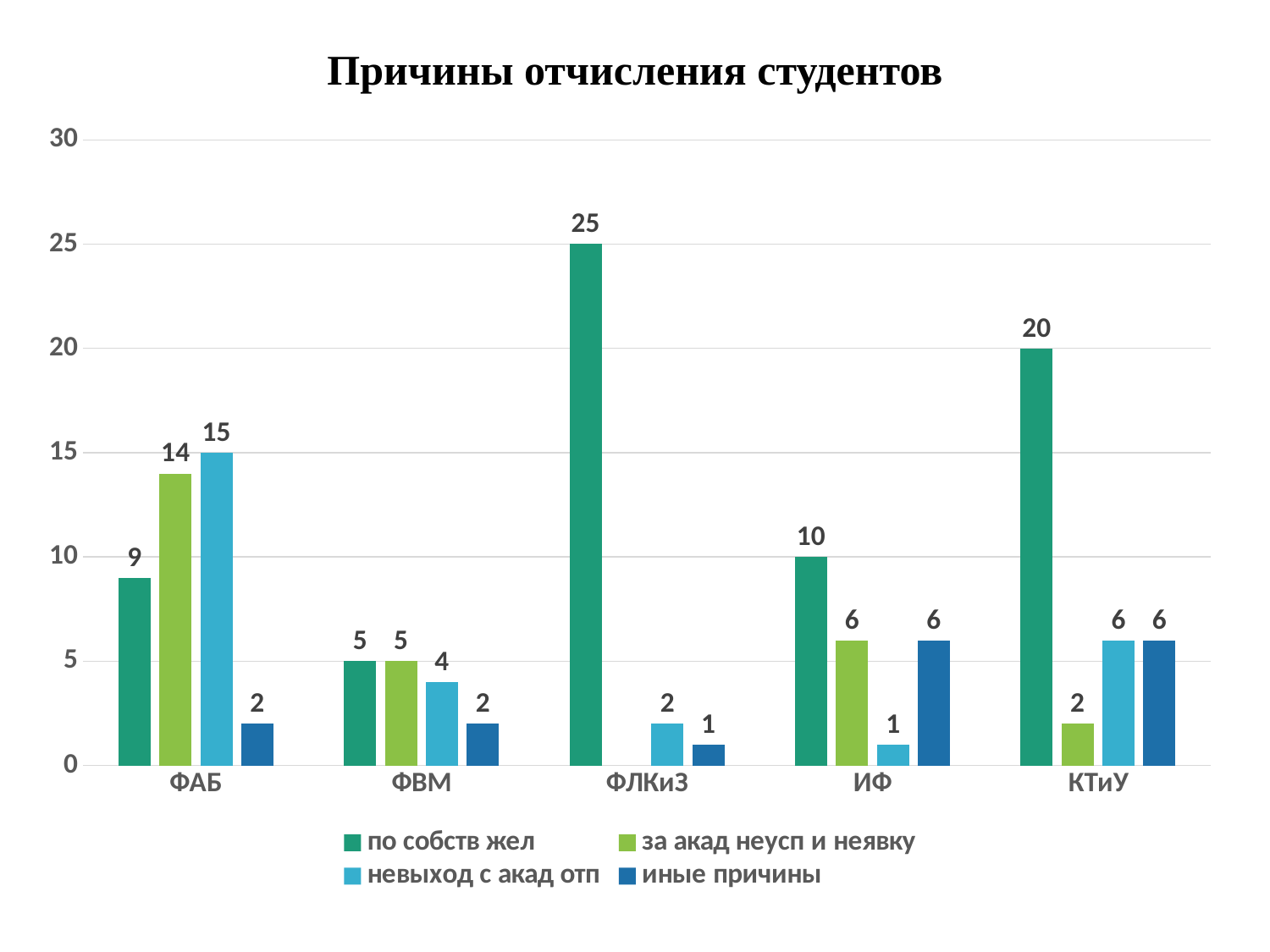
What kind of chart is shown on the slide? bar chart What is the difference between the 'по собств жел' values for ФЛКиЗ and КТиУ? 5 Is the 'по собств жел' value for ИФ greater or less than 5? greater Which category has the lowest value in the series 'невыход с акад отп'? ИФ What is the title of the chart? Причины отчисления студентов Which is larger: the 'за акад неусп и неявку' value for ФАБ or for ИФ? ФАБ What is the value for ФАБ in the series 'невыход с акад отп'? 15 What is the value for ФЛКиЗ in the series 'по собств жел'? 25 Which category has the highest value in the series 'по собств жел'? ФЛКиЗ What is the value for КТиУ in the series 'за акад неусп и неявку'? 2 How many categories are shown on the x axis? 5 How many series does the legend list? 4